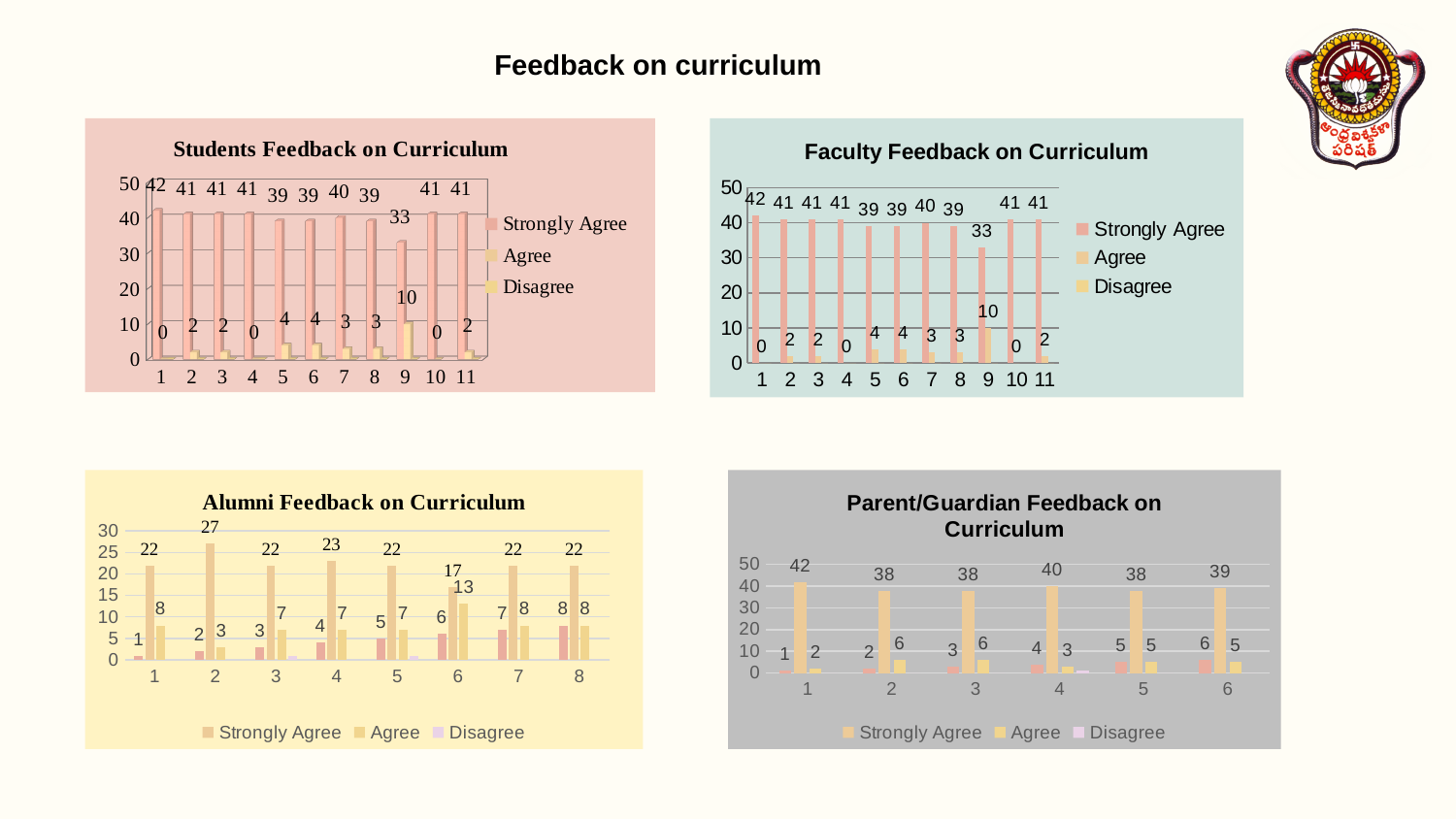
In the Students Feedback on Curriculum chart, which category has the lowest Strongly Agree value? 9 In the Students Feedback on Curriculum chart, what is the Strongly Agree value for category 9? 33 What kind of chart is the Students Feedback on Curriculum chart? Bar chart In the Alumni Feedback on Curriculum chart, how many categories are shown on the x axis? 8 In the Students Feedback on Curriculum chart, which is larger: the Strongly Agree value for category 1 or for category 9? Category 1 In the Faculty Feedback on Curriculum chart, what is the Strongly Agree value for category 1? 42 In the Faculty Feedback on Curriculum chart, what is the difference between the Strongly Agree and Agree values for category 9? 23 In the Students Feedback on Curriculum chart, what is the Agree value for category 9? 10 In the Parent/Guardian Feedback on Curriculum chart, what is the highest value labelled on any bar? 42 In the Alumni Feedback on Curriculum chart, which category has the tallest bar? 2 In the Students Feedback on Curriculum chart, how many categories are shown on the x axis? 11 In the Faculty Feedback on Curriculum chart, how many series does the legend list? 3